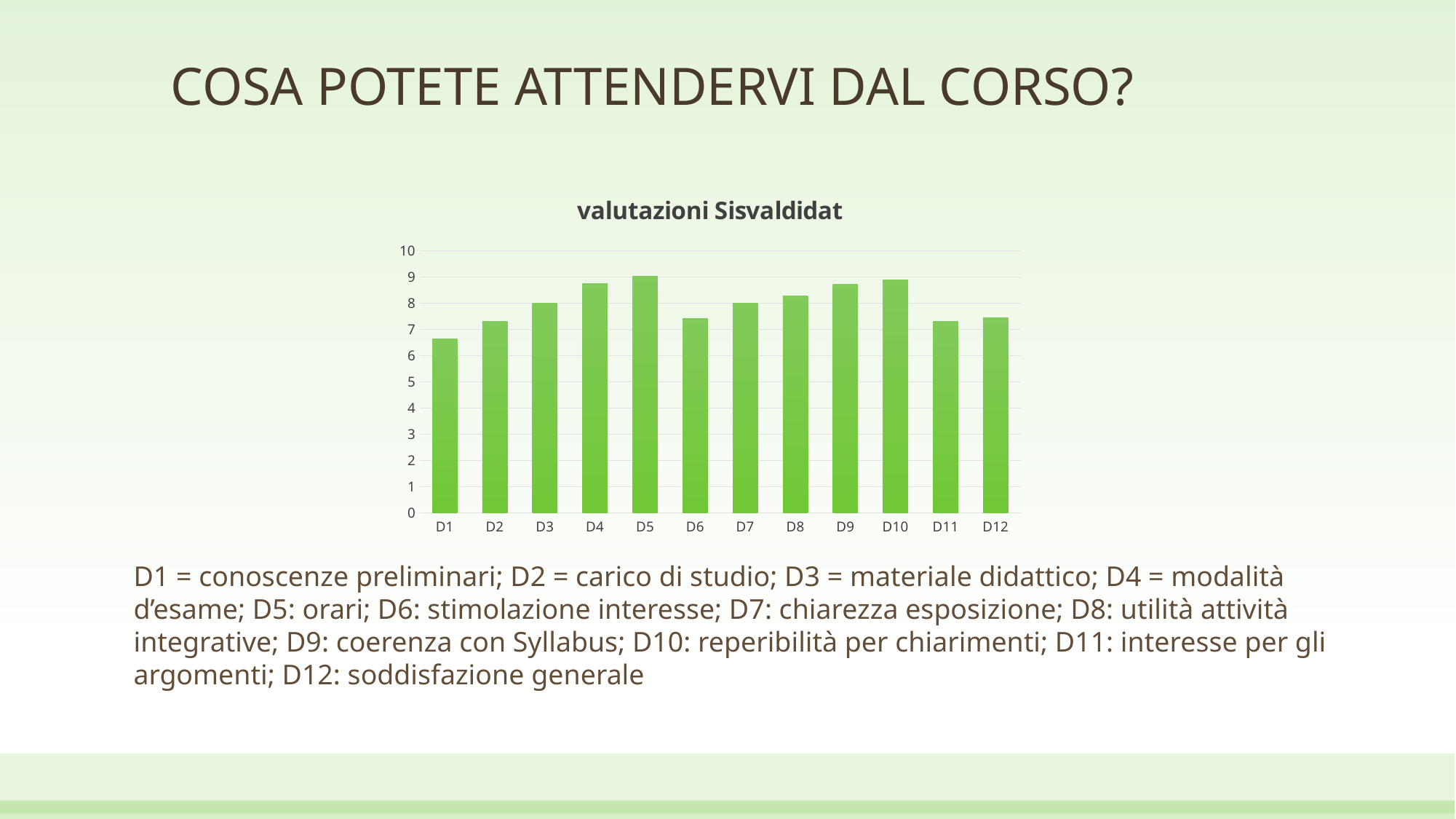
What is the title of the chart? valutazioni Sisvaldidat Is the value for D10 greater or less than 8? greater What kind of chart is shown on the slide? bar chart Is the value for D5 greater or less than 8? greater Is the value for D11 greater or less than 8? less How many categories are plotted on the x axis of the chart? 12 Which is larger, the value for D1 or the value for D6? D6 Which category has the lowest bar in the chart? D1 Which is larger, the value for D4 or the value for D2? D4 What is the highest value shown on the vertical axis of the chart? 10